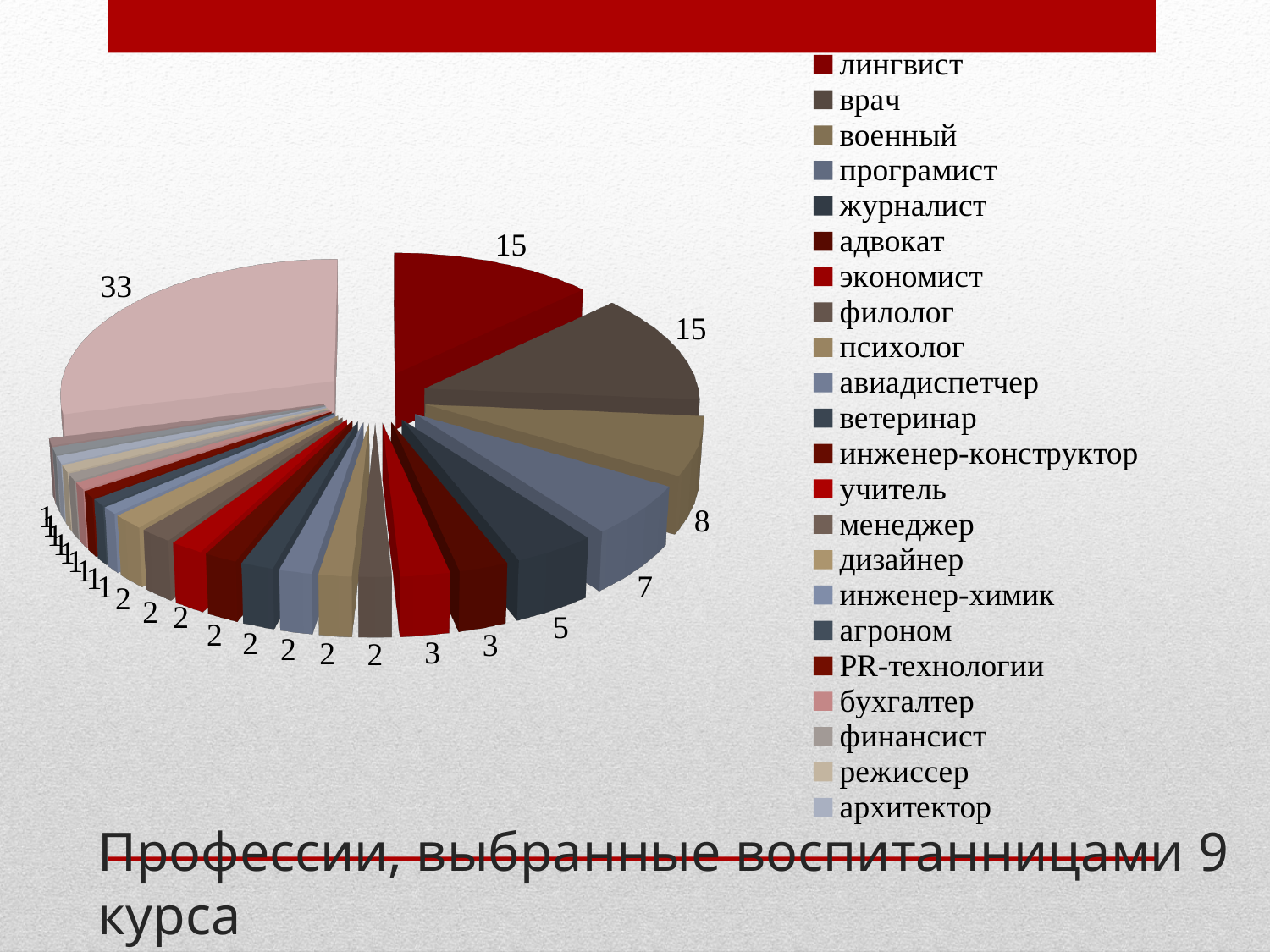
What is the smallest value labelled on the pie chart? 1 What is the difference between the values for лингвист and военный? 7 Which is larger, the value for военный or the value for програмист? военный What is the value for лингвист? 15 What is the first entry listed in the legend? лингвист What is the largest value labelled on the pie chart? 33 What is the value for журналист? 5 What is the value for програмист? 7 What is the value for военный? 8 What is the value for врач? 15 What kind of chart is shown on the slide? pie chart How many entries does the legend list? 22